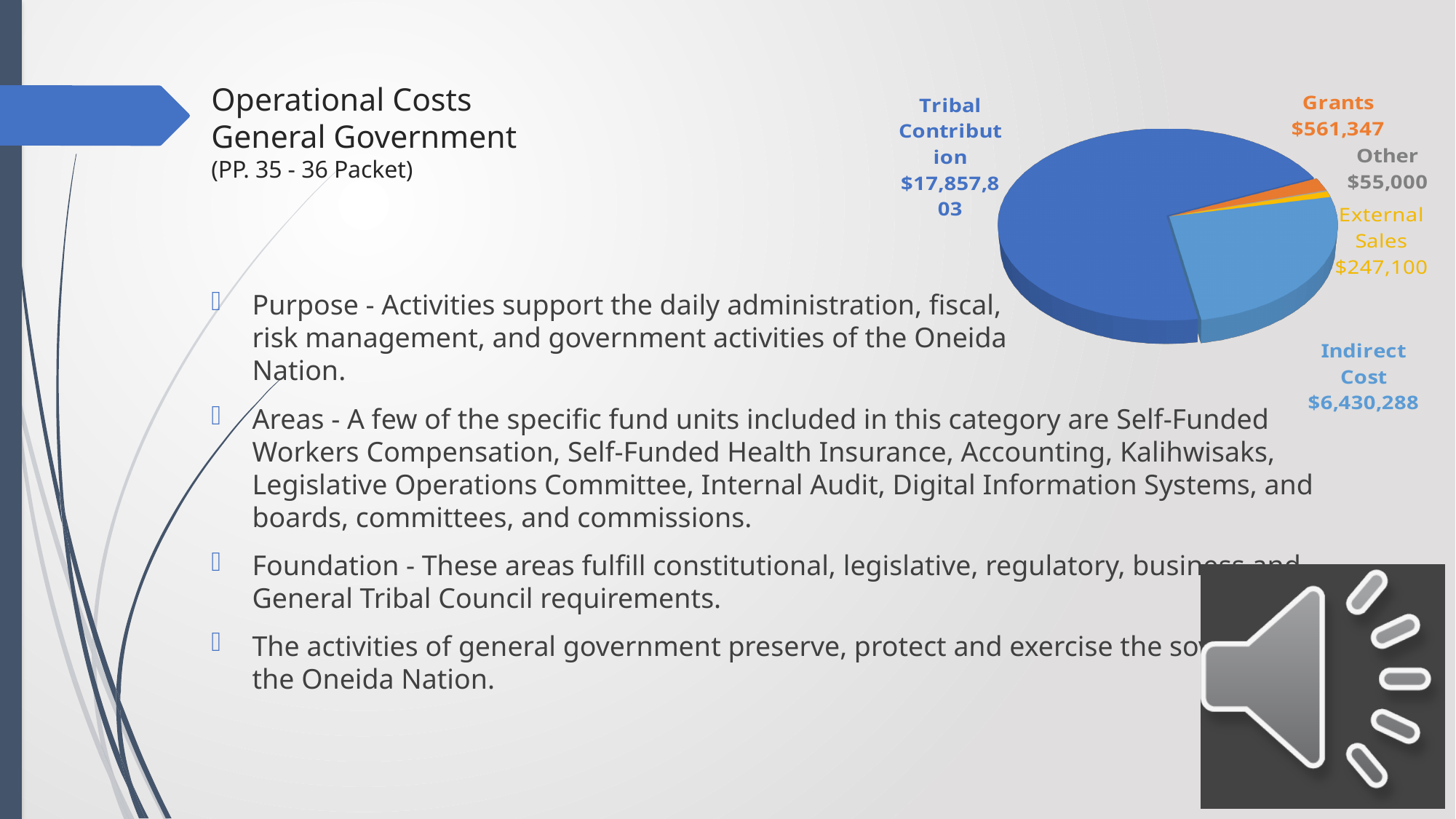
What is the difference between Grants and Other? $506,347 Which category has the largest slice of the pie? Tribal Contribution What is the value of the Indirect Cost slice? $6,430,288 Which category has the smallest slice of the pie? Other What is the value of the Tribal Contribution slice? $17,857,803 What is the value of the External Sales slice? $247,100 What kind of chart is shown on the slide? Pie chart What colour is the Grants slice of the pie? Orange What is the value of the Grants slice? $561,347 What is the difference between Tribal Contribution and Indirect Cost? $11,427,515 Which is larger, Grants or External Sales? Grants How many slices does the pie chart have? 5